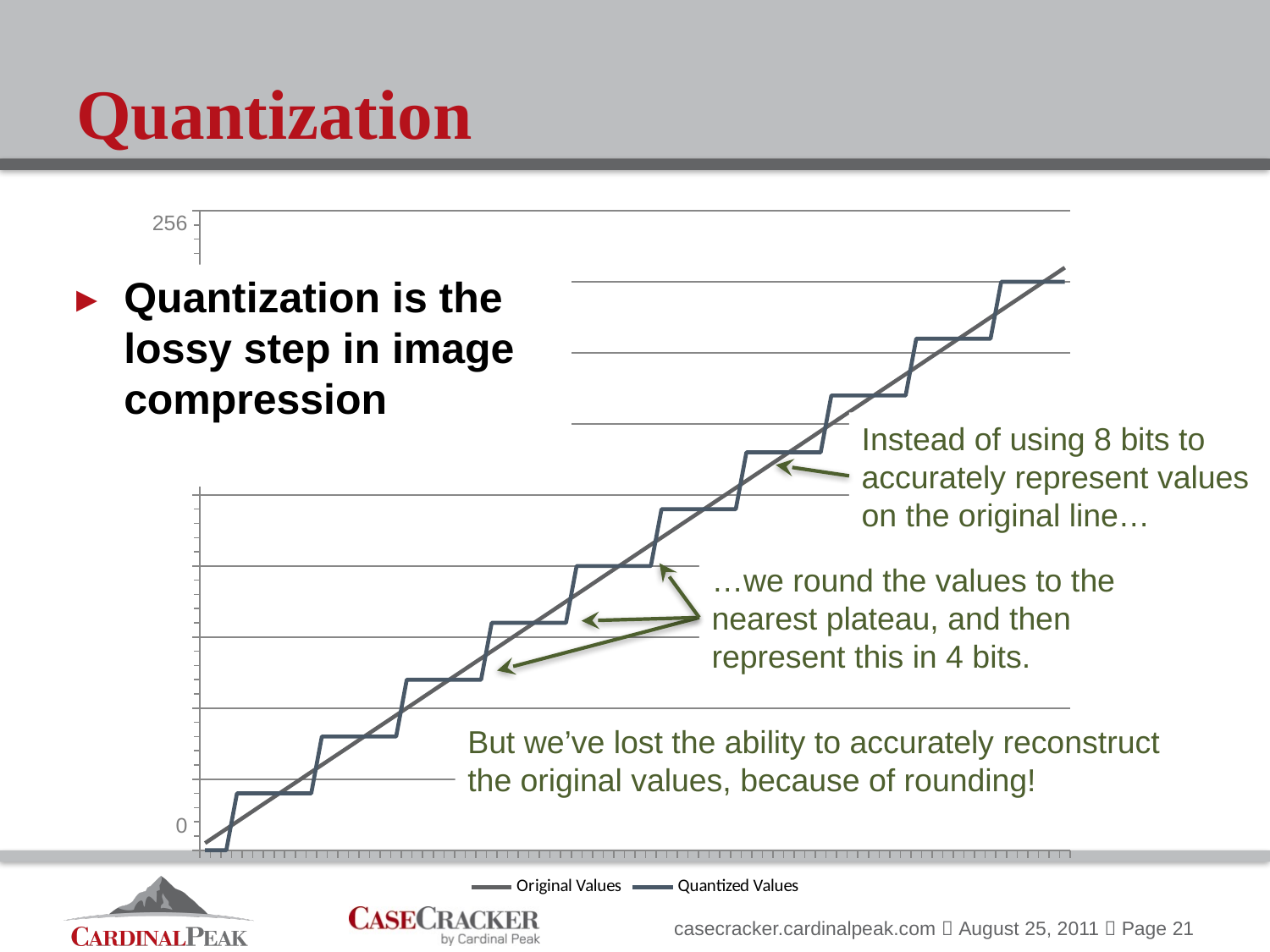
Is the highest point of the Original Values line greater or less than 256? less What is the lowest value labelled on the chart's y axis? 0 Which series is drawn as a staircase of plateaus rather than a straight line? Quantized Values How many series does the chart's legend list? 2 Do the values of the Original Values series rise or fall along the x axis? rise What kind of chart is shown on the slide? line chart What is the highest value labelled on the chart's y axis? 256 What are the two series named in the chart's legend? Original Values and Quantized Values Do the values of the Quantized Values series rise or fall overall along the x axis? rise